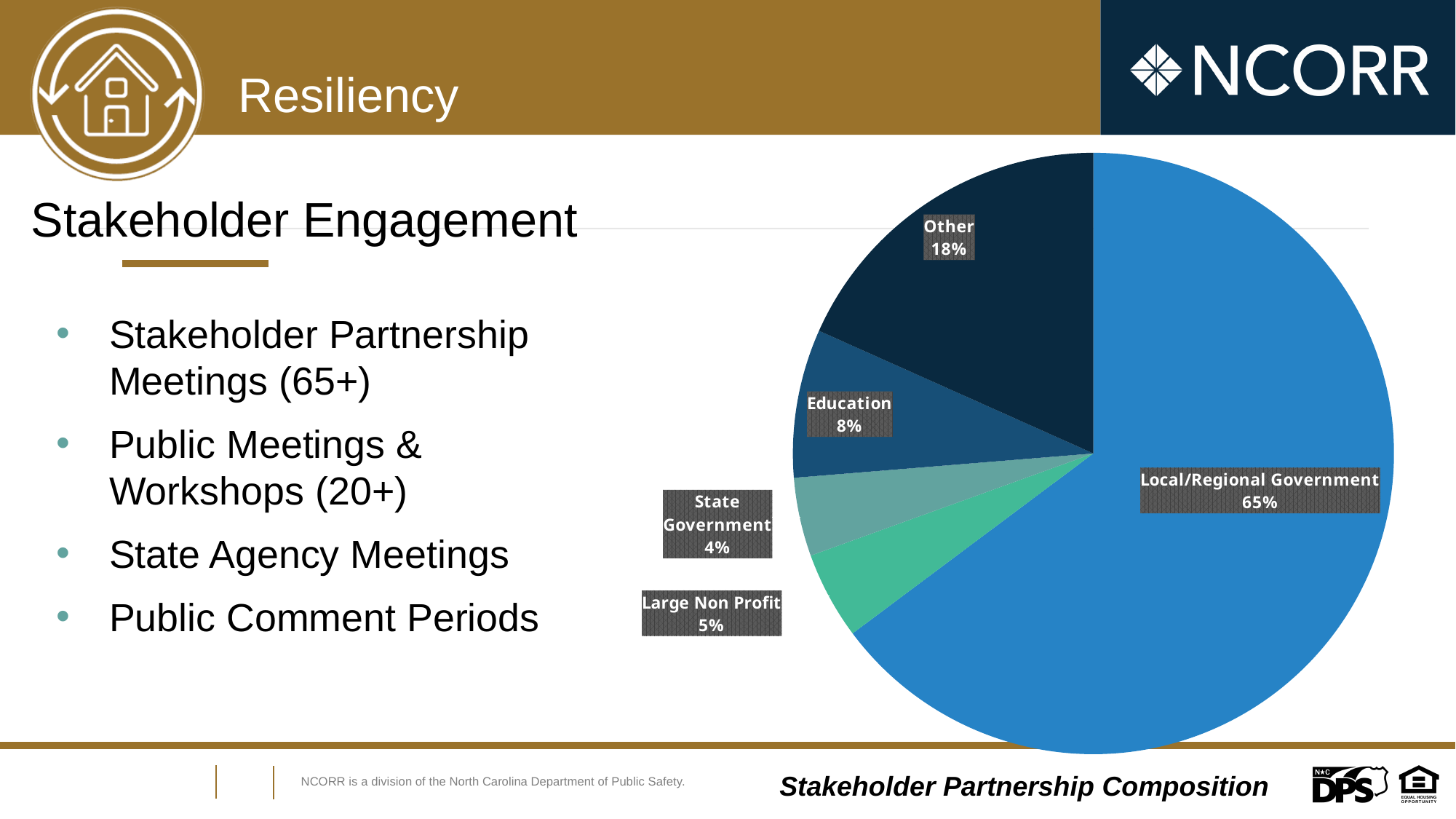
What share of the pie does Local/Regional Government hold? 65% Which is larger, the Large Non Profit slice or the State Government slice? Large Non Profit What is the difference in percentage points between Other and Education? 10 What percentage is shown for Education? 8% What percentage is shown for State Government? 4% Which category has the smallest slice of the pie? State Government What percentage is shown for Large Non Profit? 5% What type of chart is shown on the slide? Pie chart What is the combined percentage of Education and Other? 26% Which category has the largest slice of the pie? Local/Regional Government What is the caption below the pie chart? Stakeholder Partnership Composition How many categories are shown in the pie chart? 5